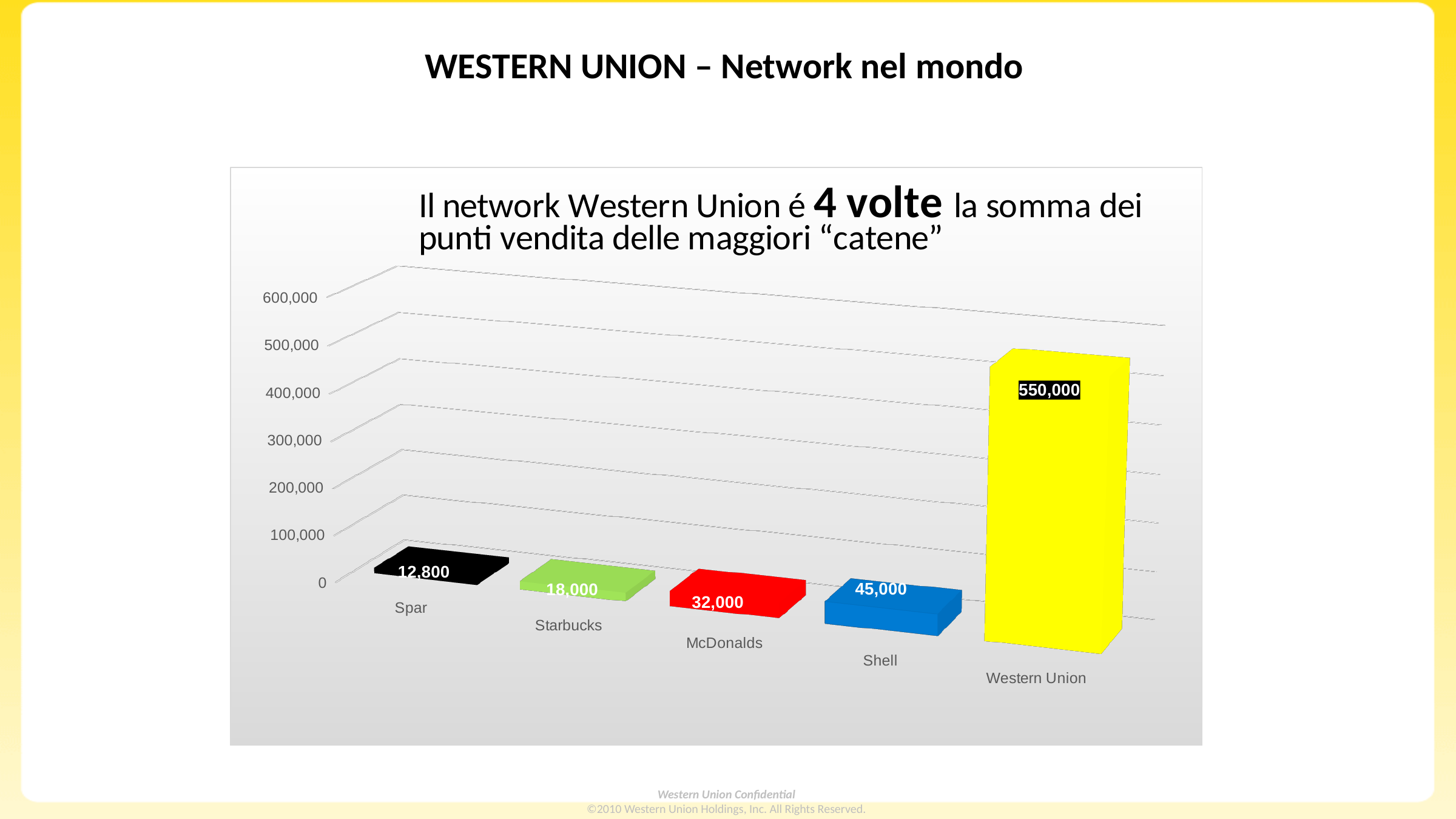
What is the difference between the values for Shell and Starbucks? 27,000 What is the value shown for Spar? 12,800 What is the value shown for Western Union? 550,000 Is the value for Western Union greater or less than 500,000? greater What kind of chart is shown on the slide? bar chart What is the value shown for McDonalds? 32,000 Which is larger, the value for McDonalds or the value for Starbucks? McDonalds Which category has the lowest value? Spar What is the value shown for Shell? 45,000 Which category has the highest value? Western Union What colour is the bar for Western Union? yellow How many categories are shown on the x axis? 5